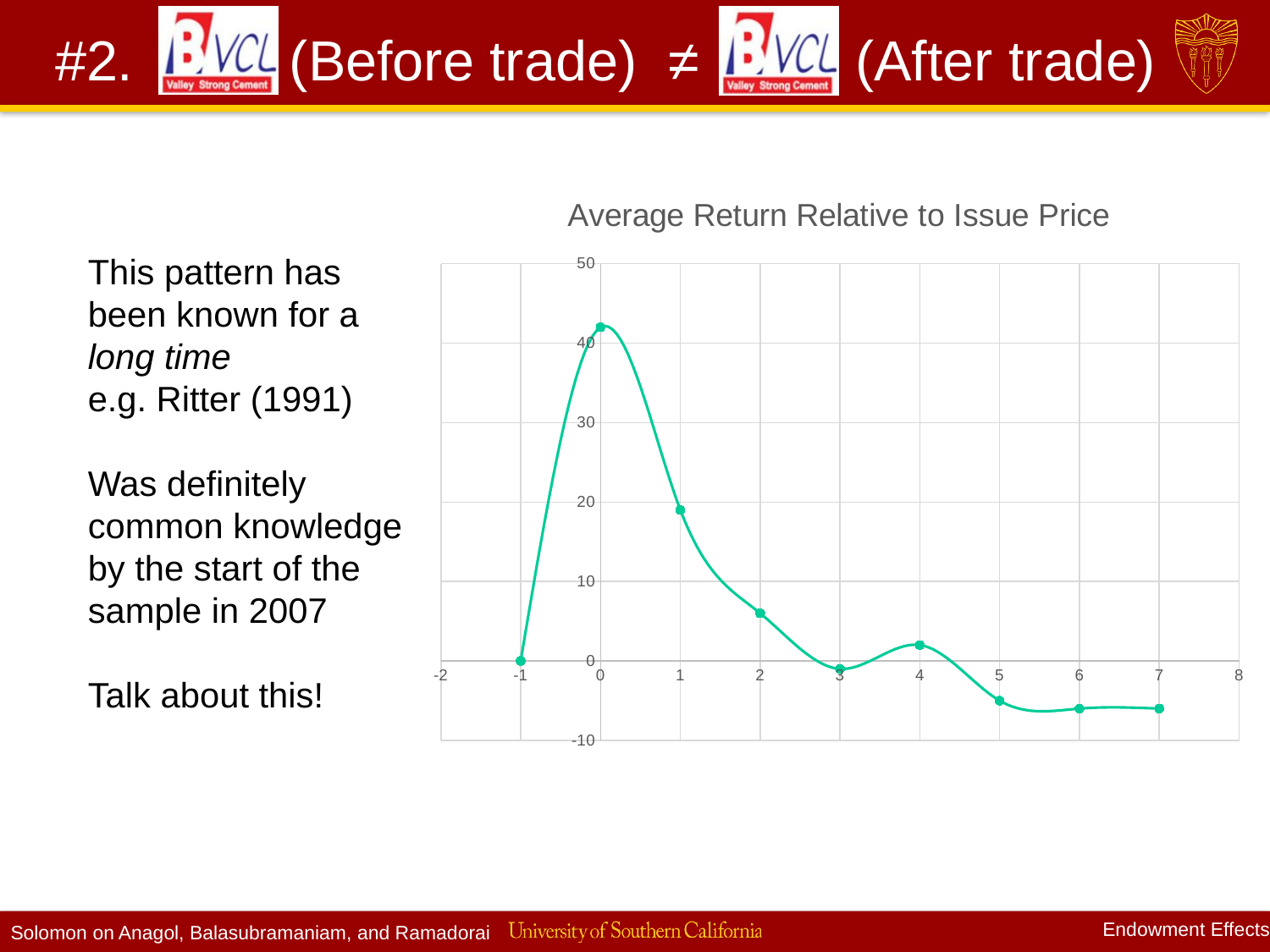
Which has the larger value, x = 1 or x = 2? x = 1 Is the value at x = 5 greater or less than 0? less What kind of chart is shown on the slide? line chart At which x value does the line reach its highest point? 0 Is the value at x = 2 greater or less than 10? less How many data points are plotted on the line? 9 Is the value at x = 4 greater or less than 0? greater Does the line rise or fall between x = 0 and x = 3? fall What is the title of the chart? Average Return Relative to Issue Price What is the highest value shown on the vertical axis? 50